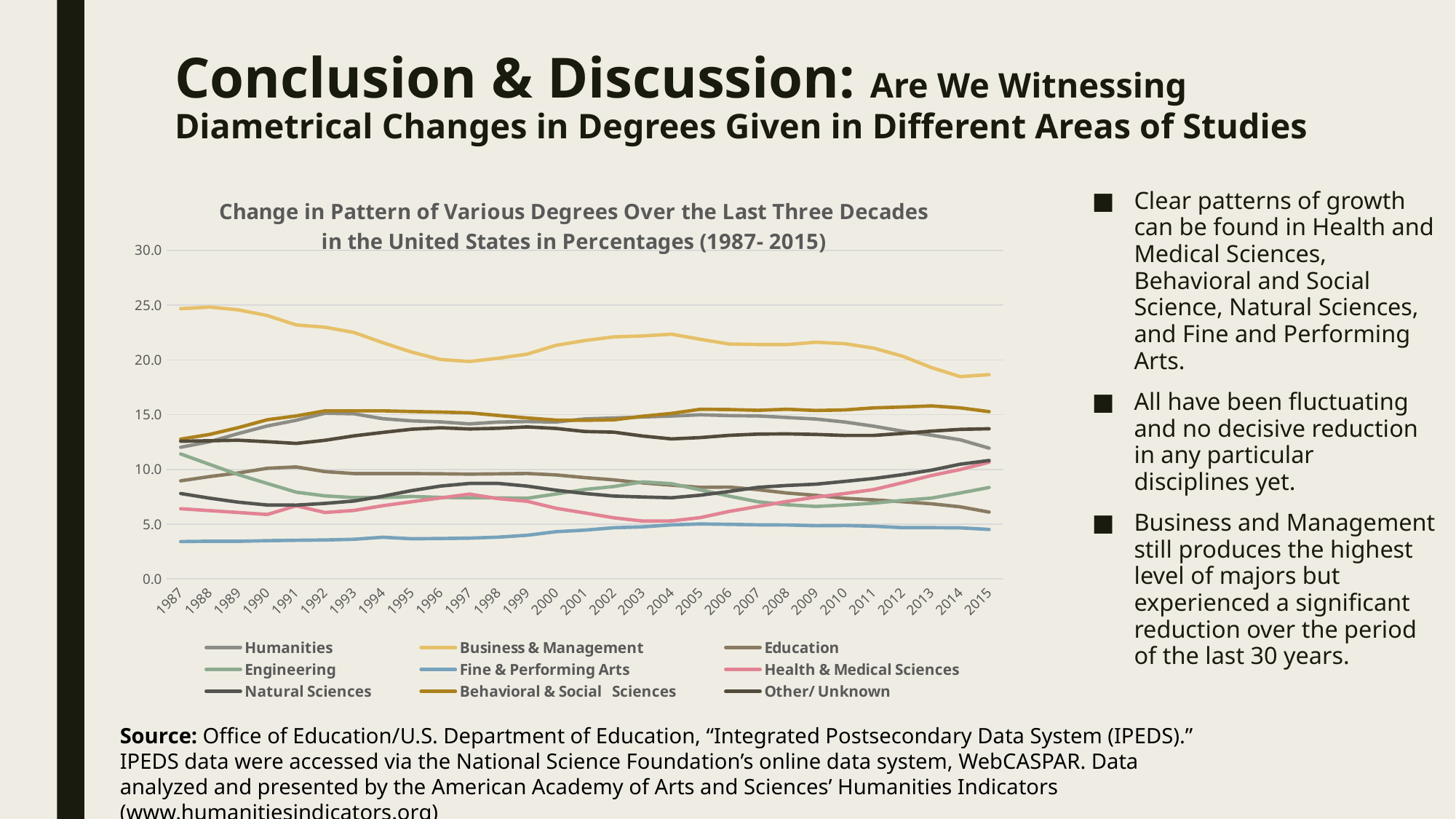
Which series has the highest values across the whole period shown in the chart? Business & Management What is the title of the chart? Change in Pattern of Various Degrees Over the Last Three Decades in the United States in Percentages (1987- 2015) Is the value for Fine & Performing Arts in 1987 greater or less than 5.0? less Does the Business & Management line rise or fall overall from 1987 to 2015? Fall Does the Health & Medical Sciences line rise or fall overall from 1987 to 2015? Rise Which series has the lowest values across the whole period shown in the chart? Fine & Performing Arts How many series does the chart's legend list? 9 Is the value for Business & Management in 1987 greater or less than 20.0? greater Is the value for Business & Management in 2015 greater or less than 20.0? less In 2015, which is larger: Engineering or Education? Engineering How many years are plotted along the x axis of the chart? 29 What kind of chart is shown on the slide? Line chart